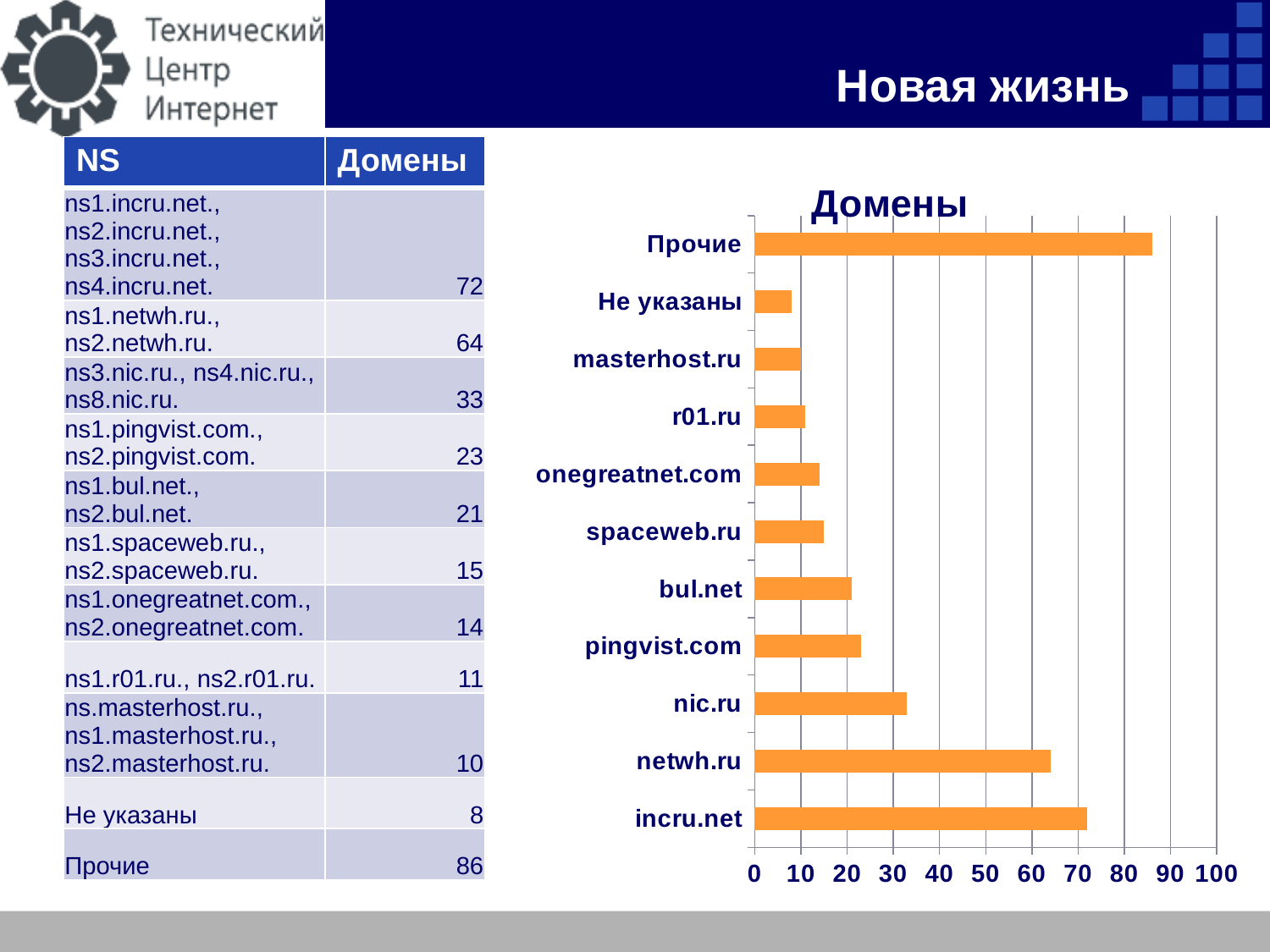
Is the value for netwh.ru greater or less than 70? less Is the value for masterhost.ru greater or less than 20? less Is the value for incru.net greater or less than 70? greater What kind of chart is shown on the slide? bar chart Which is larger, the value for pingvist.com or the value for spaceweb.ru? pingvist.com Which is larger, the value for Прочие or the value for incru.net? Прочие What is the highest value shown on the horizontal axis of the chart? 100 How many categories (bars) does the chart show? 11 Which category has the longest bar in the chart? Прочие Which category has the shortest bar in the chart? Не указаны What is the title of the chart? Домены